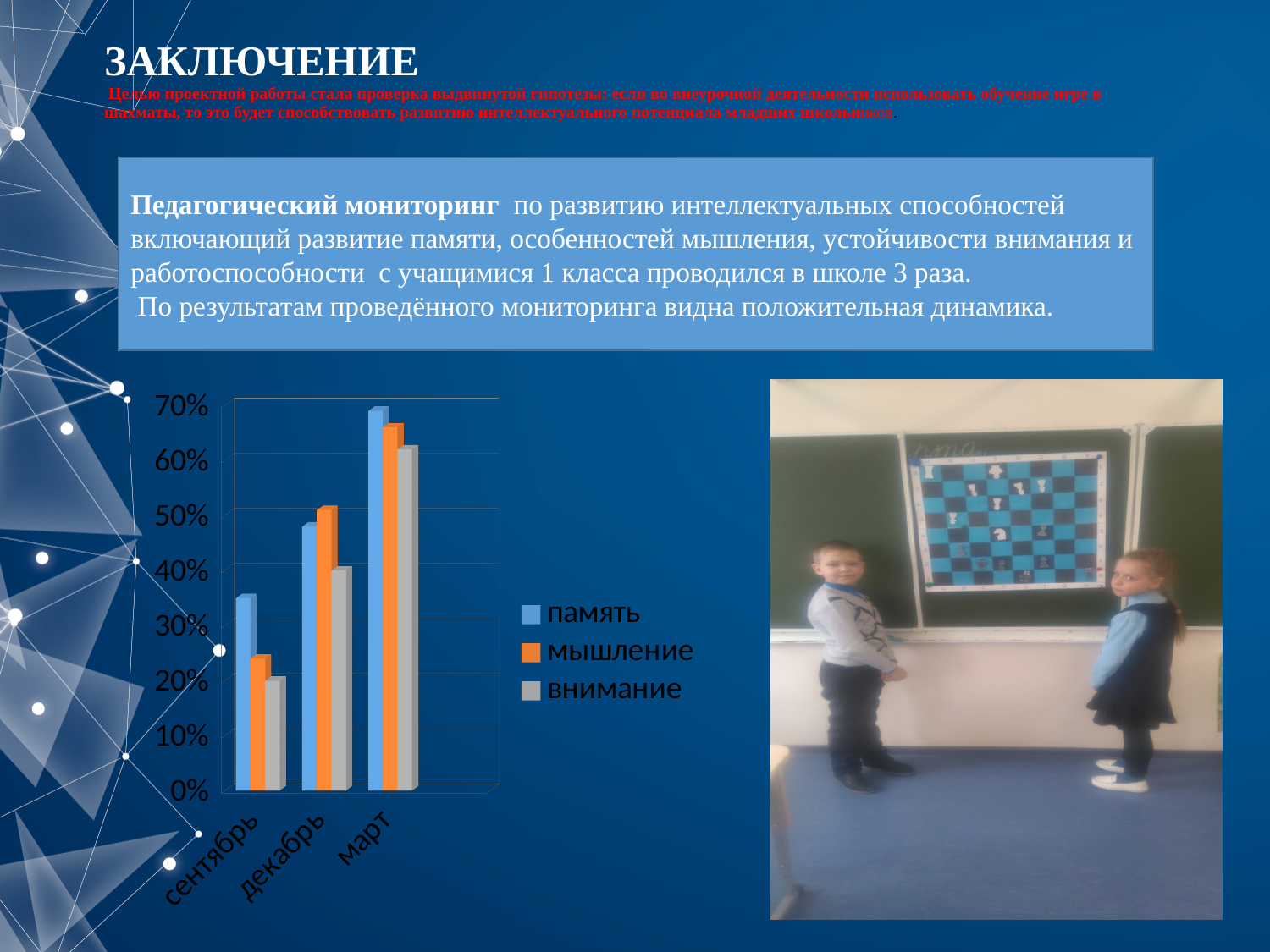
Do the values for память rise or fall from сентябрь to март? rise Is the value for память in сентябрь greater or less than 30%? greater Which series are listed in the chart legend? память, мышление, внимание How many series does the chart legend list? 3 How many categories are shown on the x axis of the chart? 3 Is the value for память in март greater or less than 60%? greater Which is larger in сентябрь: the value for память or the value for внимание? память In which category is the value for внимание lowest? сентябрь In which category is the value for память highest? март What kind of chart is shown on the slide? bar chart Is the value for внимание in декабрь greater or less than 50%? less Do the values for внимание rise or fall from сентябрь to март? rise